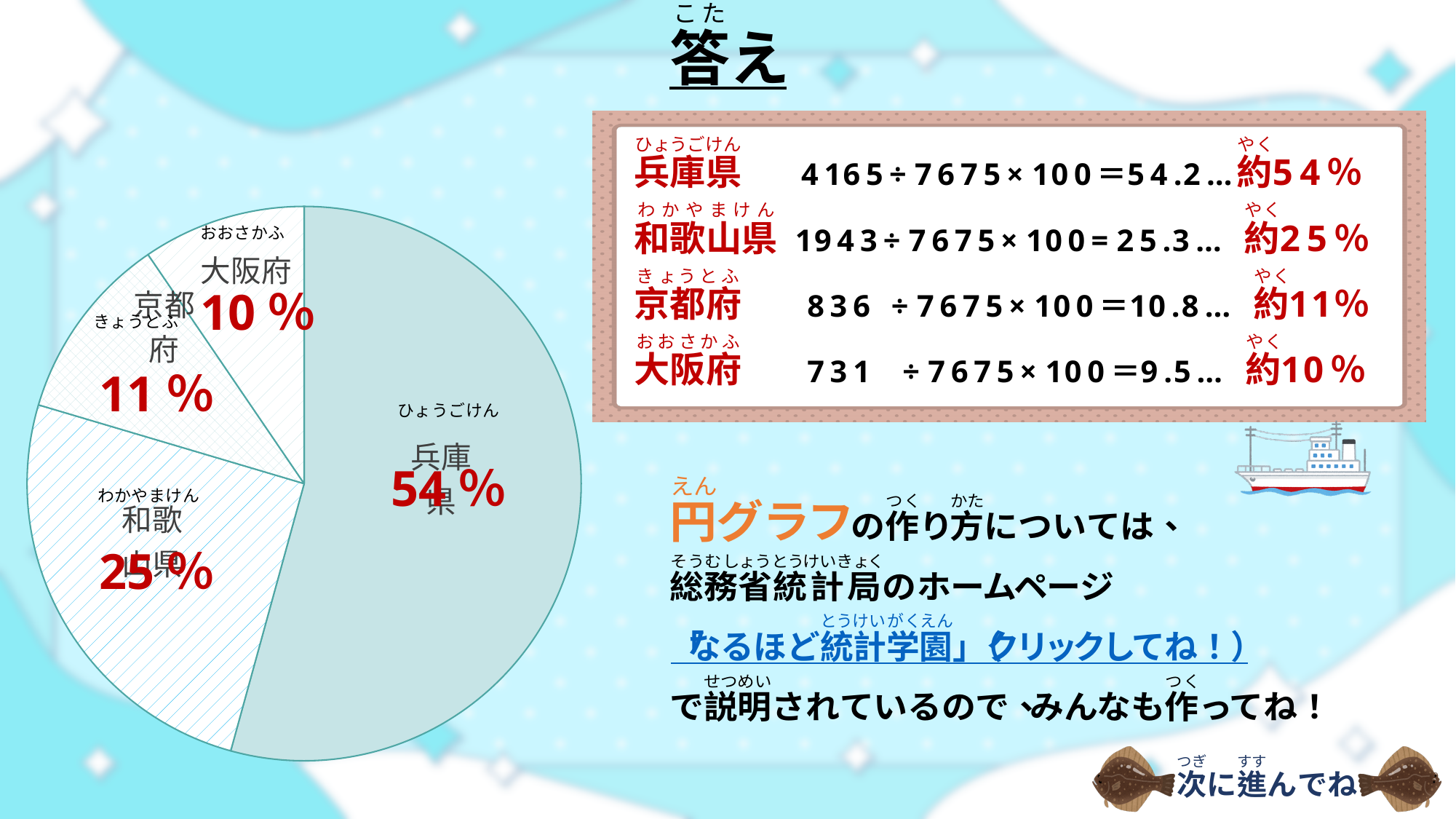
What is the combined percentage of the 京都府 and 大阪府 slices? 21% What percentage does the pie chart show for 兵庫県? 54% What percentage does the pie chart show for 京都府? 11% Which slice of the pie chart is drawn with a solid light blue fill rather than a hatched pattern? 兵庫県 How many slices does the pie chart have? 4 What is the difference in percentage points between the 兵庫県 slice and the 和歌山県 slice? 29 What percentage does the pie chart show for 和歌山県? 25% Which slice is larger in the pie chart, 和歌山県 or 京都府? 和歌山県 What kind of chart is shown on the left of the slide? pie chart Which prefecture has the smallest slice in the pie chart? 大阪府 What percentage does the pie chart show for 大阪府? 10% Which prefecture has the largest slice in the pie chart? 兵庫県